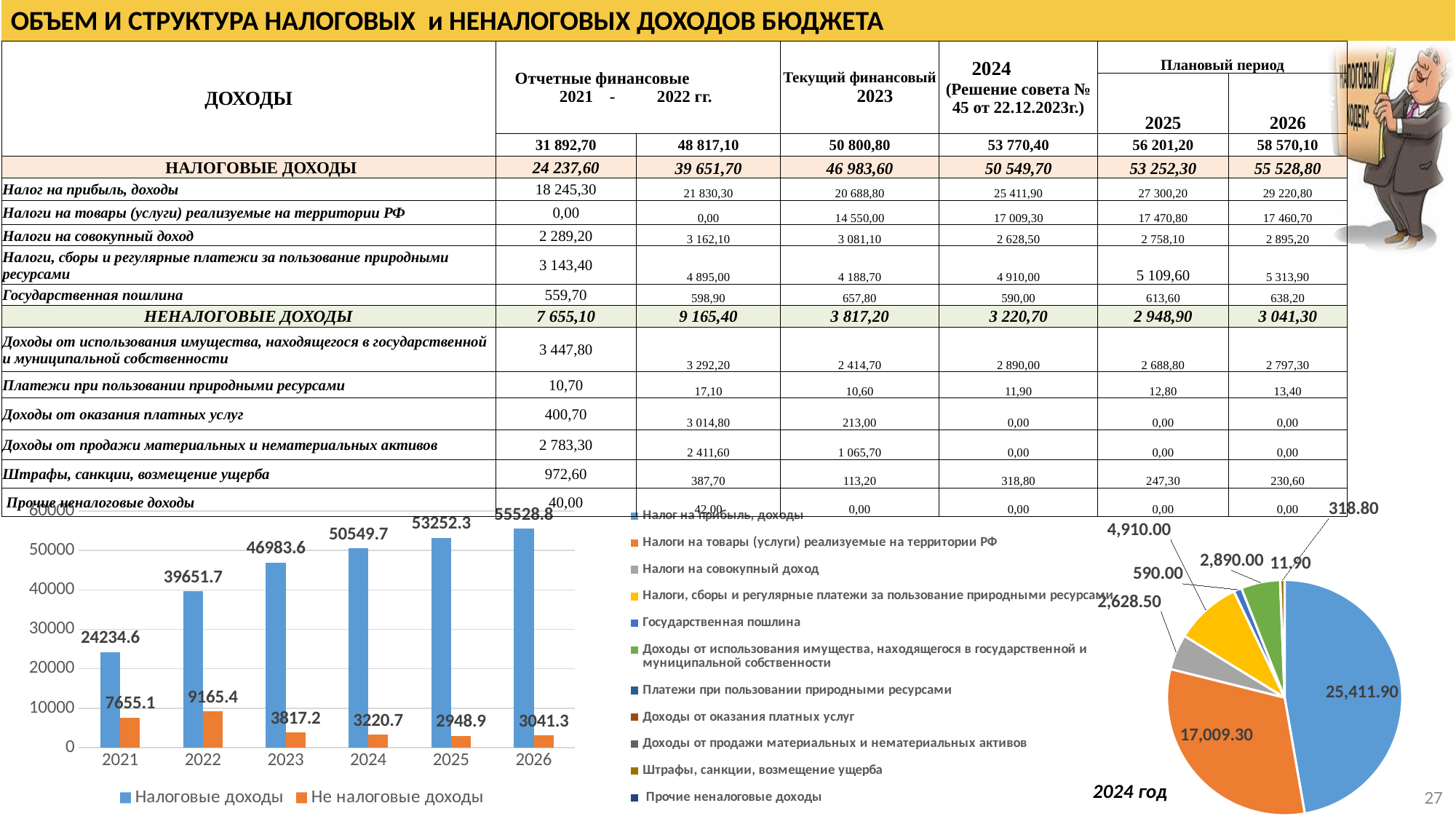
What kind of chart is shown at the bottom left of the slide? bar chart In the bar chart at the bottom left, what is the value for Налоговые доходы in 2023? 46983.6 How many entries does the legend of the pie chart labelled 2024 год list? 11 How many series does the legend of the bar chart at the bottom left list? 2 How many years are shown on the x axis of the bar chart at the bottom left? 6 In the bar chart at the bottom left, do the values for Налоговые доходы rise or fall from 2021 to 2026? rise In the bar chart at the bottom left, what is the difference between Налоговые доходы in 2022 and in 2021? 15417.1 In the pie chart labelled 2024 год, what is the value of the largest slice? 25,411.90 In the bar chart at the bottom left, which year has the highest value for Налоговые доходы? 2026 In the bar chart at the bottom left, which year has the lowest value for Не налоговые доходы? 2025 In the bar chart at the bottom left, what is the value for Не налоговые доходы in 2025? 2948.9 In the bar chart at the bottom left, which year has the larger value for Не налоговые доходы, 2021 or 2022? 2022